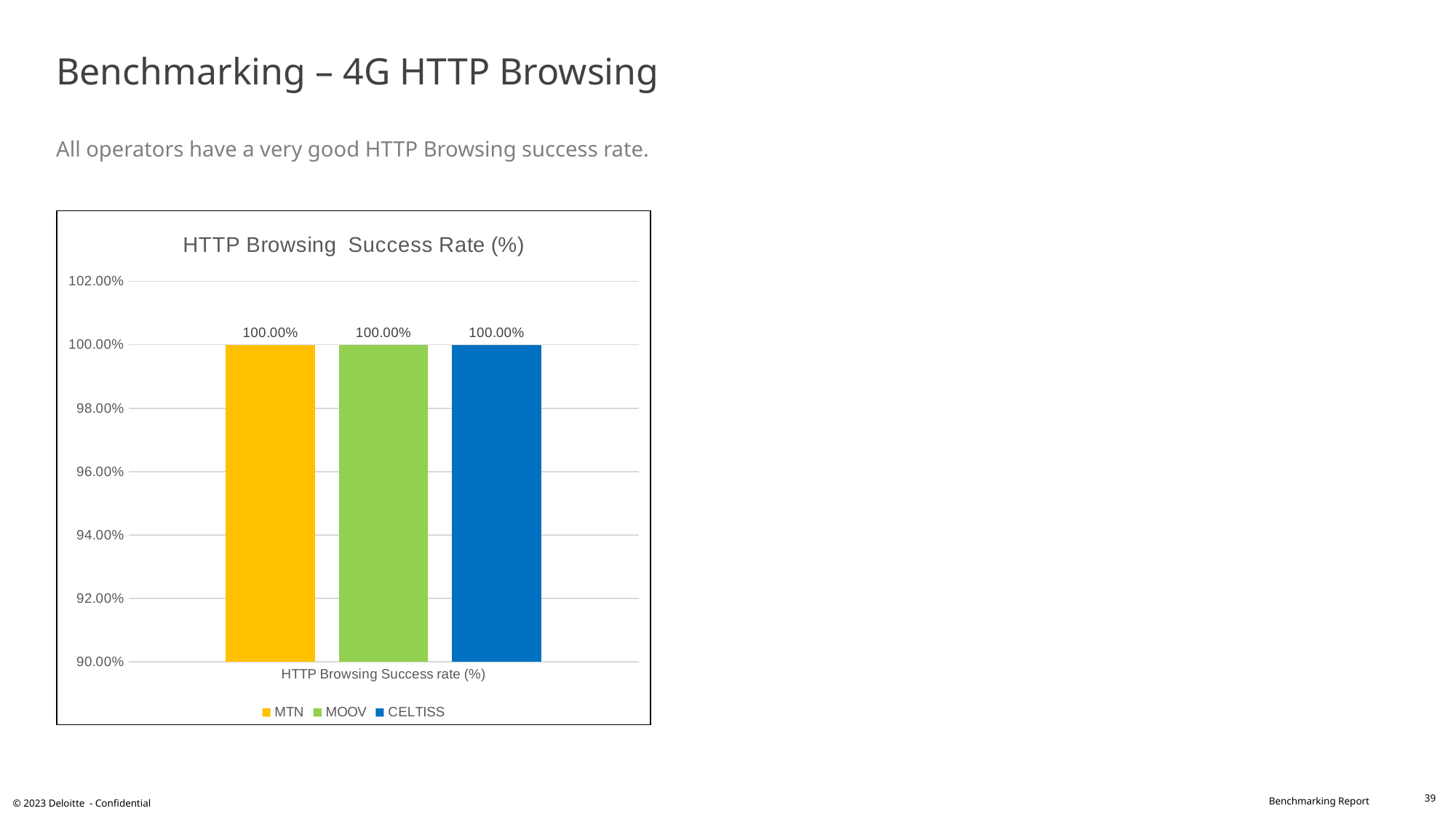
How many bars are plotted in the chart? 3 Do all three operators have the same HTTP Browsing Success Rate? Yes What is the title of the chart? HTTP Browsing Success Rate (%) What is the HTTP Browsing Success Rate for MOOV? 100.00% Which colour represents CELTISS in the chart? Blue What is the difference between the HTTP Browsing Success Rate of MTN and CELTISS? 0.00% What kind of chart is shown on the slide? Bar chart What is the HTTP Browsing Success Rate for MTN? 100.00% What is the HTTP Browsing Success Rate for CELTISS? 100.00% Is the HTTP Browsing Success Rate for MOOV greater or less than 98.00%? greater How many series does the legend list? 3